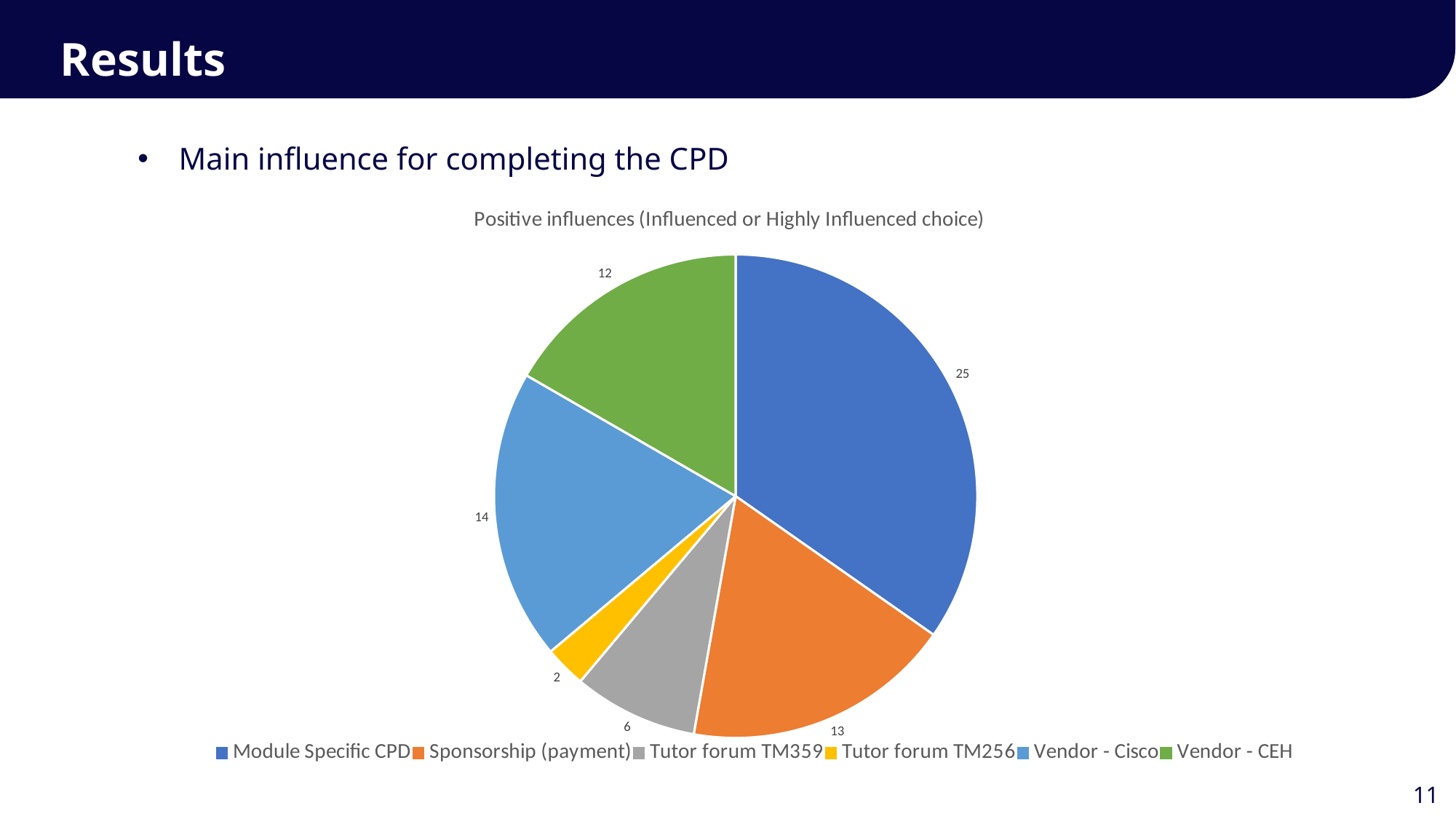
Which category has the smallest slice? Tutor forum TM256 What is the total of all slices in the pie chart? 72 Which is larger, Vendor - Cisco or Sponsorship (payment)? Vendor - Cisco What is the value for Tutor forum TM256? 2 What is the difference between the values for Module Specific CPD and Vendor - CEH? 13 What is the value for Sponsorship (payment)? 13 What is the value for Module Specific CPD? 25 What is the value for Vendor - Cisco? 14 What is the title of the chart? Positive influences (Influenced or Highly Influenced choice) Which category has the largest slice? Module Specific CPD What type of chart is shown on the slide? pie chart How many categories does the pie chart have? 6